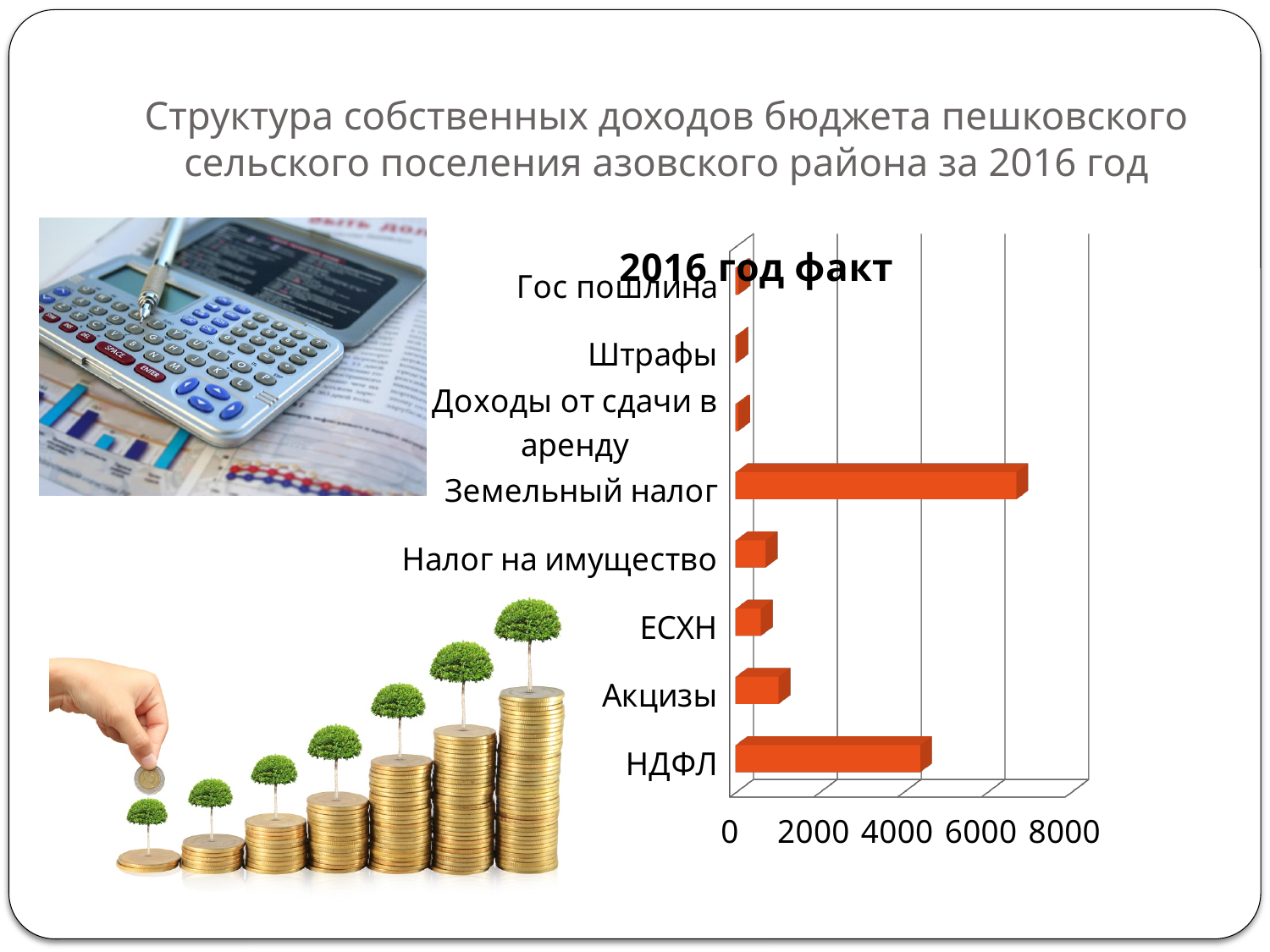
How many categories are shown in the chart? 8 Which is larger, the value for НДФЛ or the value for Акцизы? НДФЛ Which category has the highest value in the chart? Земельный налог Is the value for Налог на имущество greater or less than 2000? less Is the value for Земельный налог greater or less than 8000? less What kind of chart is shown on the slide? bar chart Is the value for НДФЛ greater or less than 6000? less Which is larger, the value for Земельный налог or the value for НДФЛ? Земельный налог What is the title of the chart? 2016 год факт